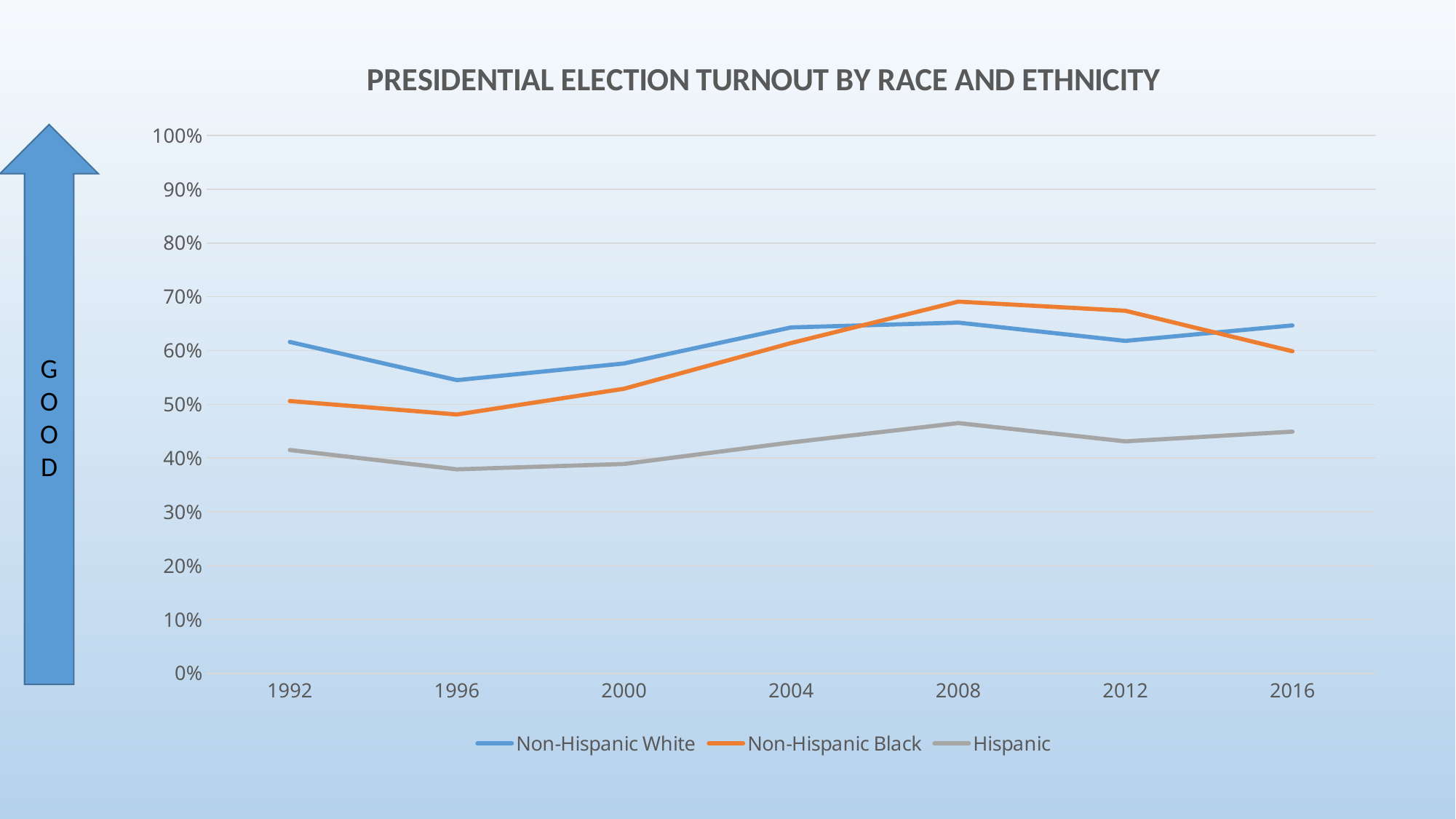
How many series does the legend list? 3 In which year does the Non-Hispanic Black series reach its highest value? 2008 Is the Hispanic turnout in 1996 greater or less than 40%? less Does the Hispanic turnout rise or fall from 1992 to 1996? Fall Which series has the highest turnout in 2008? Non-Hispanic Black In which year does the Non-Hispanic Black series reach its lowest value? 1996 Is the Non-Hispanic Black turnout in 2008 greater or less than 60%? greater What kind of chart is shown on the slide? Line chart How many election years are plotted along the x axis? 7 What is the title of the chart? PRESIDENTIAL ELECTION TURNOUT BY RACE AND ETHNICITY Which series has the lowest turnout in every year shown? Hispanic In 2016, which is larger: Non-Hispanic White turnout or Non-Hispanic Black turnout? Non-Hispanic White